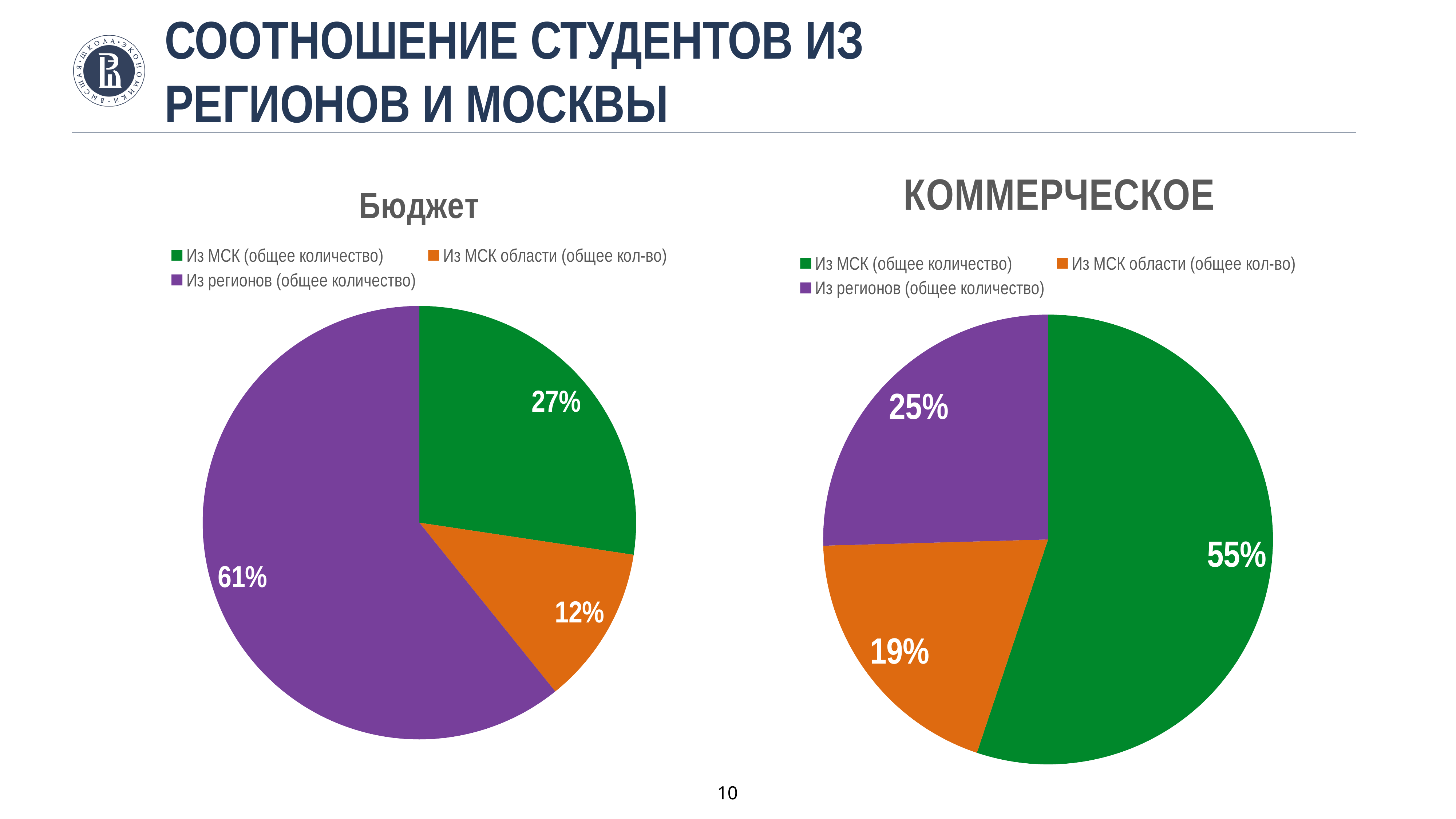
In the 'КОММЕРЧЕСКОЕ' pie chart, what share is labelled for 'Из МСК (общее количество)'? 55% In the 'Бюджет' pie chart, which category has the largest slice? Из регионов (общее количество) Which is larger in the 'КОММЕРЧЕСКОЕ' pie chart: the share for 'Из МСК (общее количество)' or the share for 'Из регионов (общее количество)'? Из МСК (общее количество) In the 'КОММЕРЧЕСКОЕ' pie chart, what share is labelled for 'Из регионов (общее количество)'? 25% How many slices does the 'Бюджет' pie chart have? 3 In the 'КОММЕРЧЕСКОЕ' pie chart, what share is labelled for 'Из МСК области (общее кол-во)'? 19% In the 'Бюджет' pie chart, what share is labelled for 'Из МСК области (общее кол-во)'? 12% In the 'Бюджет' pie chart, what share is labelled for 'Из регионов (общее количество)'? 61% In the 'Бюджет' pie chart, what share is labelled for 'Из МСК (общее количество)'? 27% In the 'КОММЕРЧЕСКОЕ' pie chart, which category has the smallest slice? Из МСК области (общее кол-во) In the 'Бюджет' pie chart, what is the difference between the shares for 'Из регионов (общее количество)' and 'Из МСК (общее количество)'? 34% What type of chart is the 'КОММЕРЧЕСКОЕ' chart? Pie chart